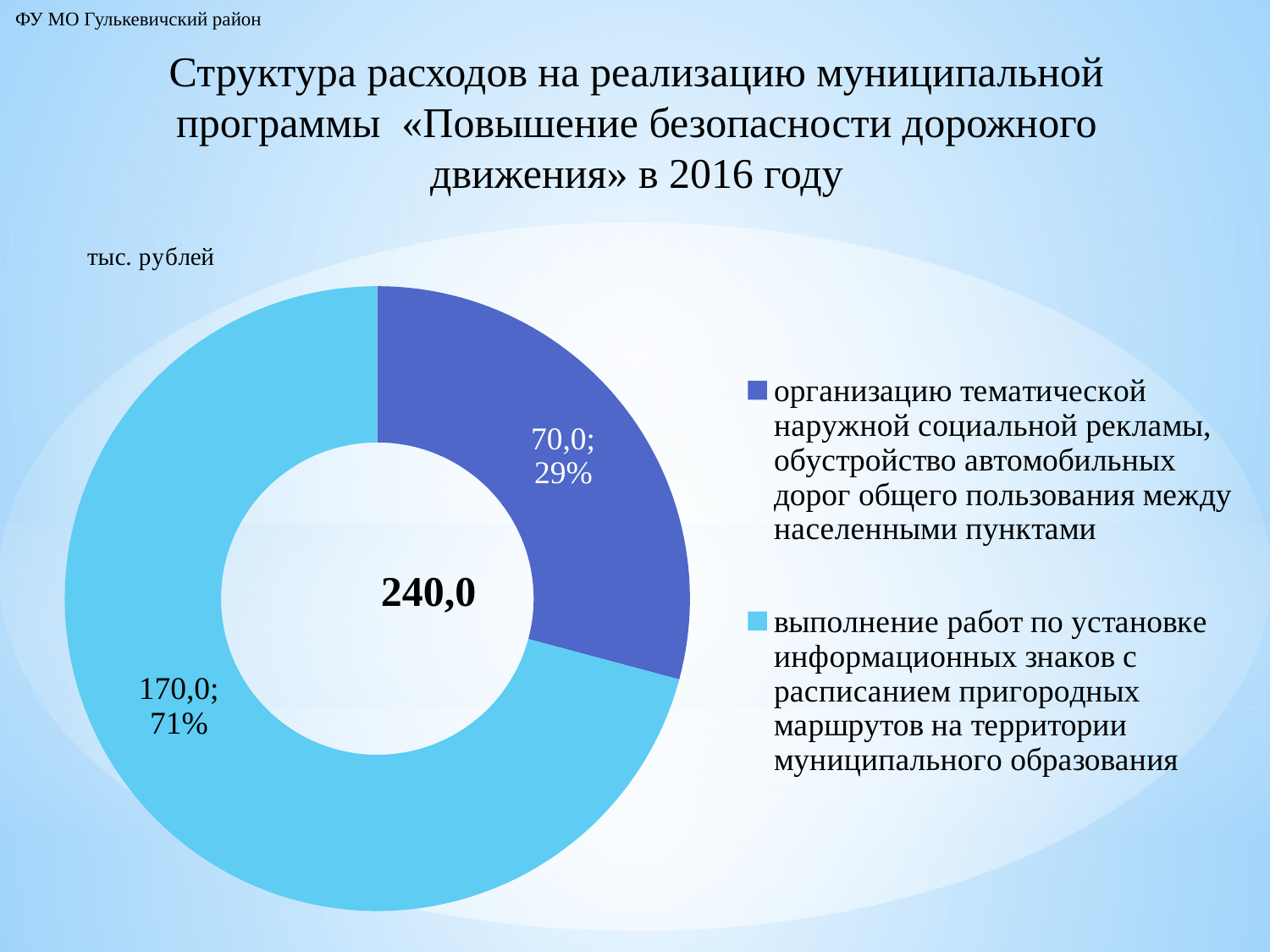
What is the value for «организацию тематической наружной социальной рекламы, обустройство автомобильных дорог общего пользования между населенными пунктами»? 70,0 What share of the total does «выполнение работ по установке информационных знаков» account for? 71% What total value is shown in the centre of the doughnut chart? 240,0 How many categories does the chart show? 2 What share of the total does «организацию тематической наружной социальной рекламы» account for? 29% Which category has the smallest slice of the chart? организацию тематической наружной социальной рекламы, обустройство автомобильных дорог общего пользования между населенными пунктами Which category has the largest slice of the chart? выполнение работ по установке информационных знаков с расписанием пригородных маршрутов на территории муниципального образования What is the difference between the value for «выполнение работ по установке информационных знаков» and the value for «организацию тематической наружной социальной рекламы»? 100,0 In what units are the chart values given? тыс. рублей Which is larger: the value for «организацию тематической наружной социальной рекламы» or the value for «выполнение работ по установке информационных знаков»? выполнение работ по установке информационных знаков What kind of chart is shown on the slide? Doughnut (pie) chart What is the value for «выполнение работ по установке информационных знаков с расписанием пригородных маршрутов на территории муниципального образования»? 170,0